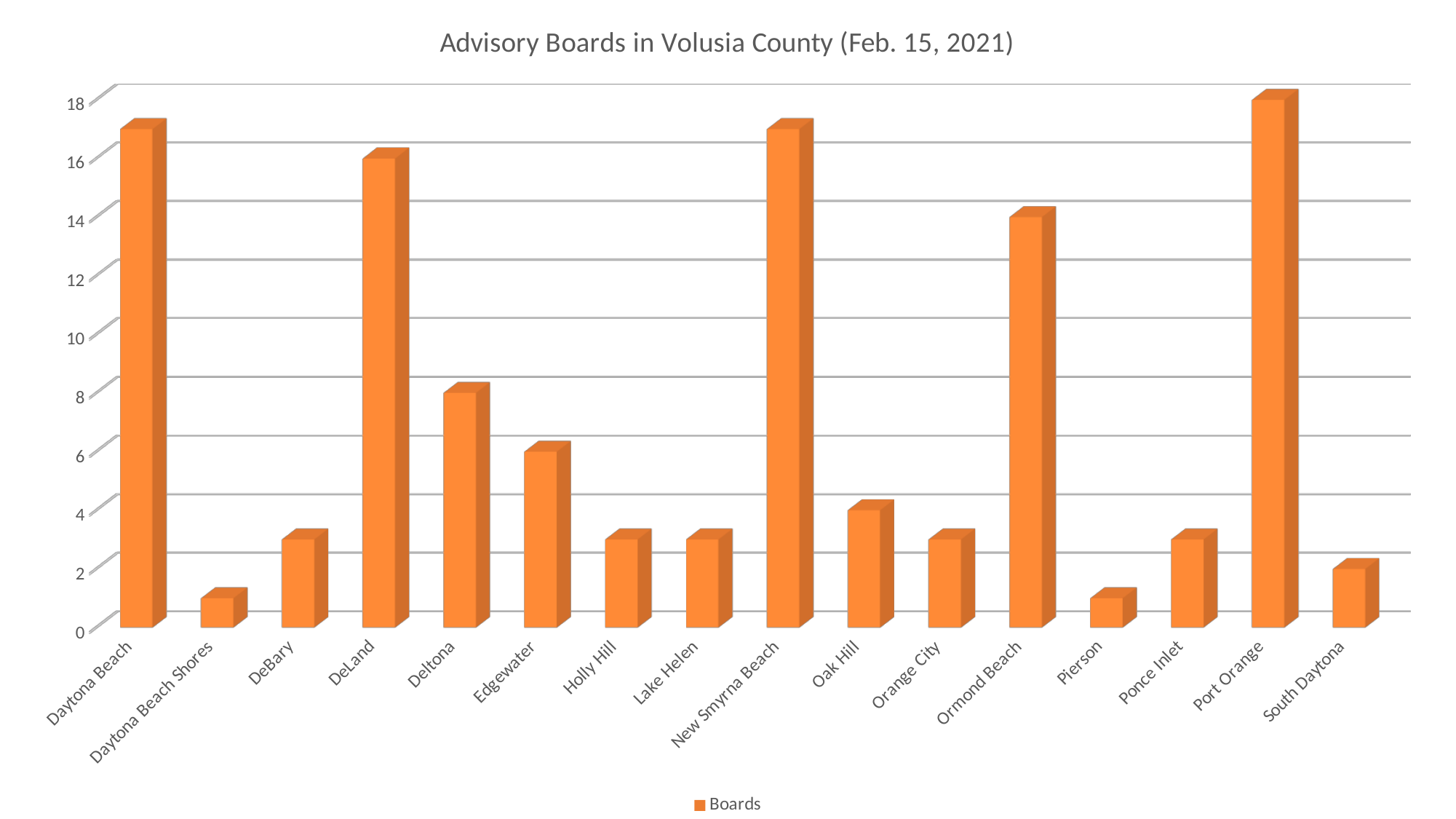
Which city has the highest number of boards? Port Orange Is the value for Daytona Beach greater or less than 16? greater What is the difference in boards between Port Orange and DeLand? 2 How many boards does DeLand have? 16 How many boards does Ormond Beach have? 14 How many cities are shown on the x axis? 16 How many boards does Deltona have? 8 What is the title of the chart? Advisory Boards in Volusia County (Feb. 15, 2021) How many series does the legend list? 1 What type of chart is shown on the slide? bar chart Which has more boards, DeLand or Ormond Beach? DeLand How many boards does Port Orange have? 18